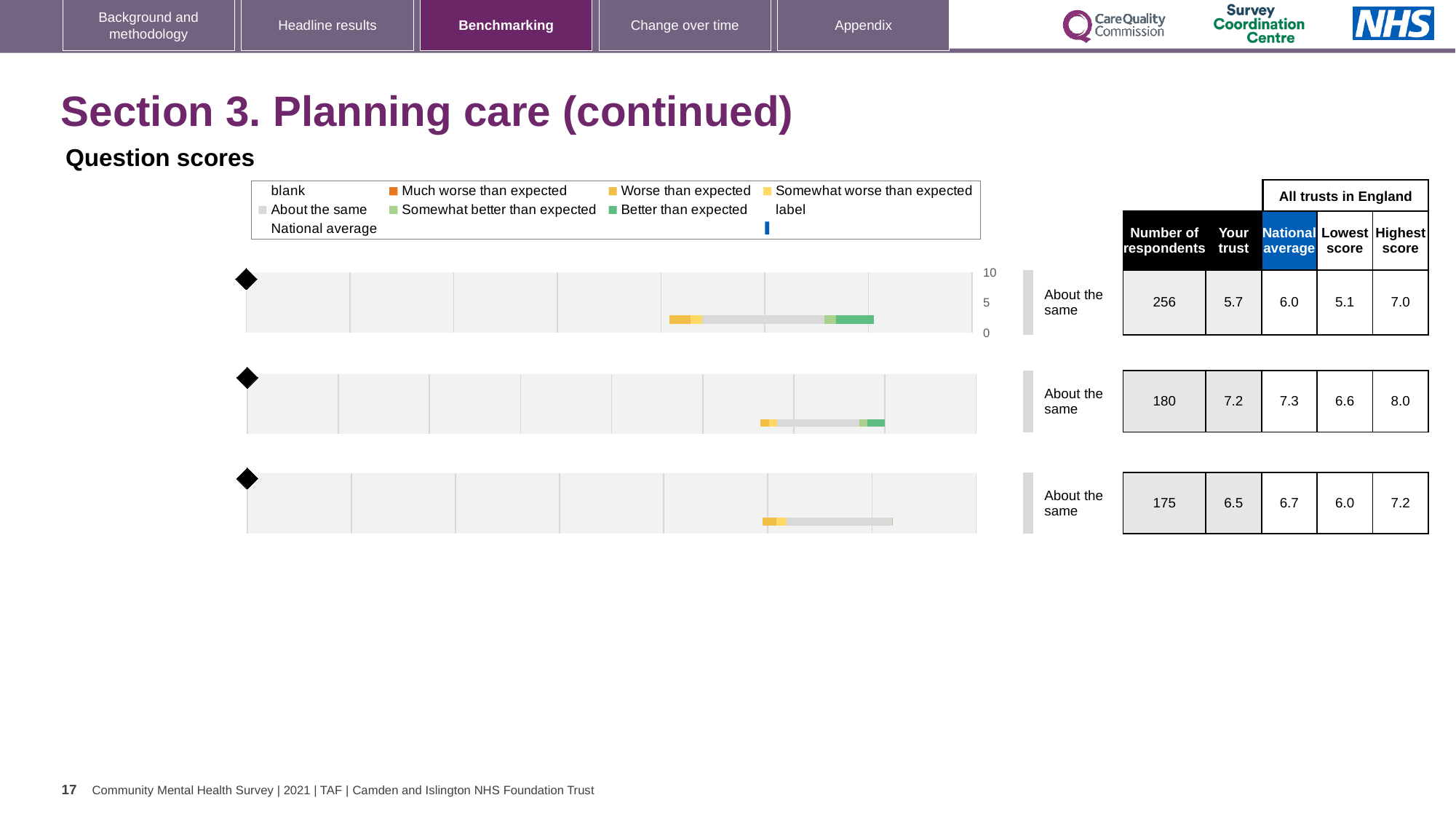
Which of the three charts has the lowest number of respondents? the bottom chart How many question score charts are shown on the slide? 3 For the bottom chart, what is the highest score among all trusts in England? 7.2 What type of chart is used to show the question scores on this slide? bar chart For the top chart, what is the number of respondents? 256 Which of the three charts has the highest 'Your trust' score? the middle chart Is the 'Your trust' score for the top chart larger or smaller than the national average? smaller What is the maximum value shown on the vertical axis of the top chart? 10 What benchmark category is given for the bottom chart? About the same For the middle chart, what is the difference between the highest score and the lowest score? 1.4 For the middle chart, what is the national average score? 7.3 For the top chart, what is the 'Your trust' score in the table? 5.7